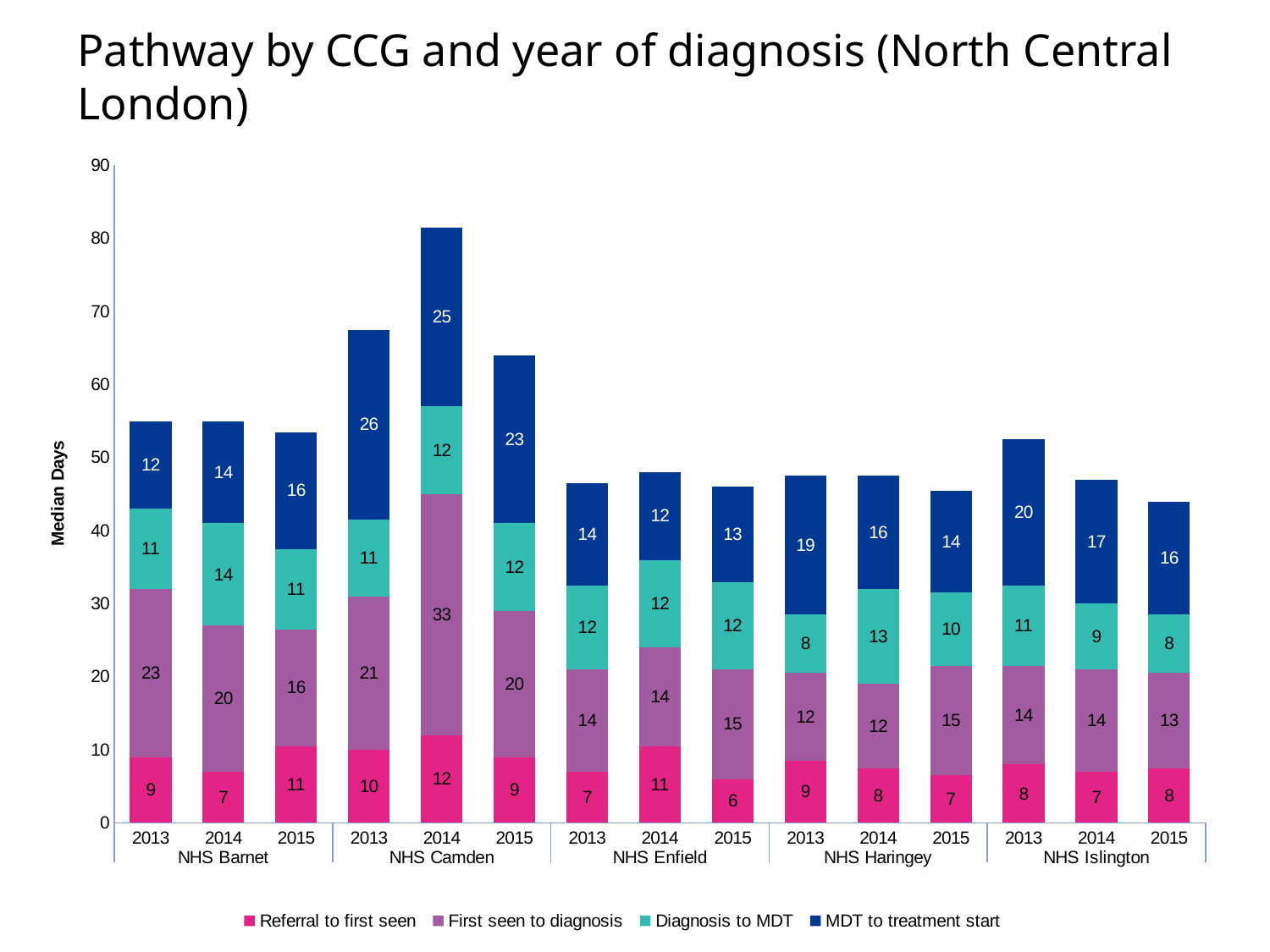
Is the total stacked bar for NHS Camden 2014 greater or less than 70? greater What is the 'First seen to diagnosis' value for NHS Camden in 2014? 33 What is the 'MDT to treatment start' value for NHS Haringey in 2013? 19 What is the label on the vertical axis? Median Days What is the 'Referral to first seen' value for NHS Enfield in 2015? 6 How many series does the legend list? 4 Which CCG and year has the tallest stacked bar? NHS Camden 2014 Which is larger: the 'First seen to diagnosis' value for NHS Barnet 2013 or for NHS Islington 2013? NHS Barnet 2013 What is the 'Diagnosis to MDT' value for NHS Barnet in 2014? 14 How many bars are plotted in the chart? 15 What is the difference between the 'MDT to treatment start' values for NHS Camden 2013 and NHS Camden 2015? 3 What type of chart is shown on the slide? stacked bar chart